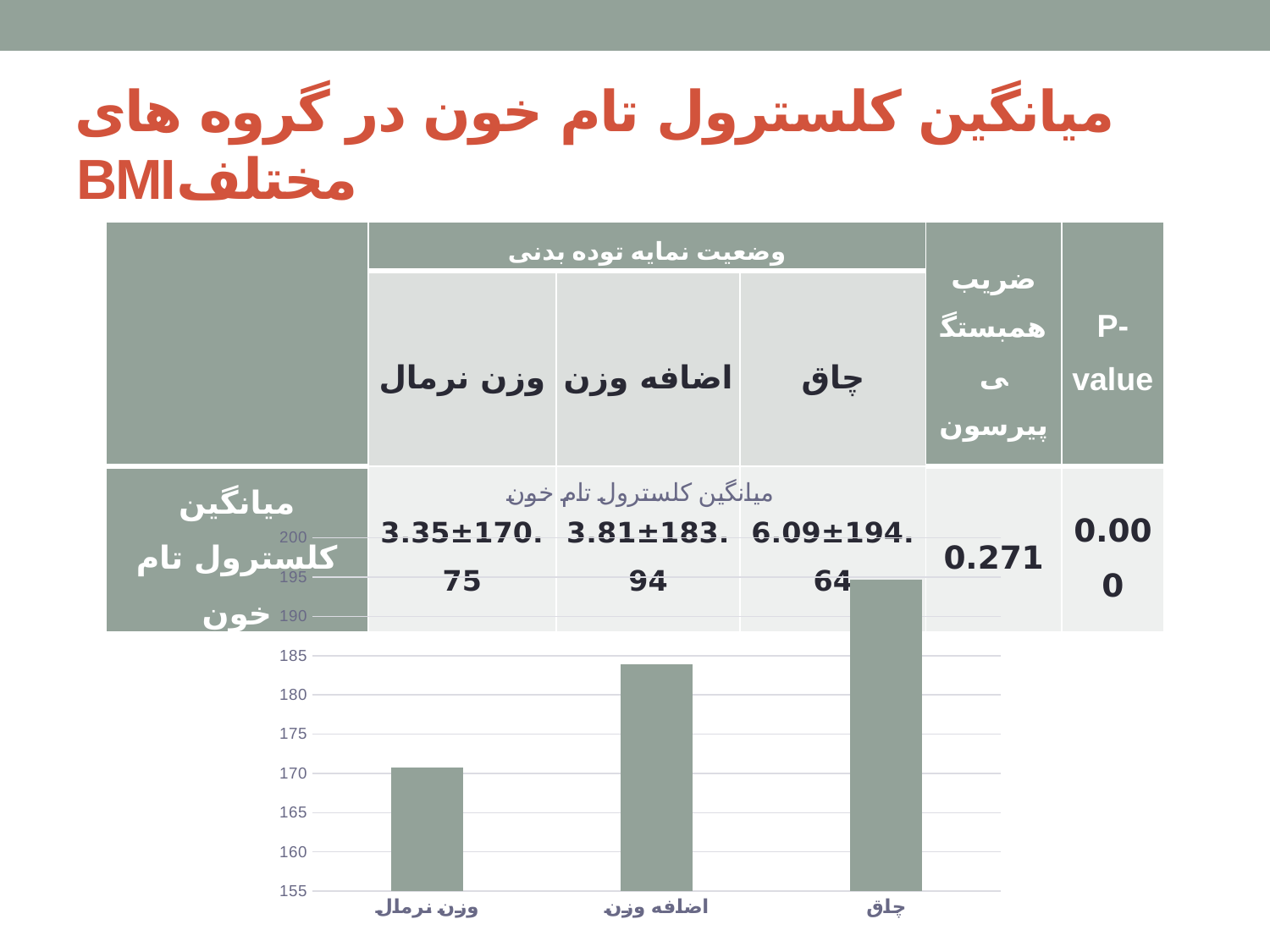
How many categories are plotted on the x axis of the bar chart? 3 Which category has the lowest bar in the chart? وزن نرمال Which bar is taller, اضافه وزن or وزن نرمال? اضافه وزن What kind of chart is shown on the slide? bar chart Do the bar values rise or fall from left to right along the x axis? rise What is the lowest tick value shown on the chart's y axis? 155 Is the value for وزن نرمال greater or less than 175? less Is the value for اضافه وزن greater or less than 180? greater Is the value for چاق greater or less than 200? less What is the title of the chart? میانگین کلسترول تام خون Which category has the highest bar in the chart? چاق